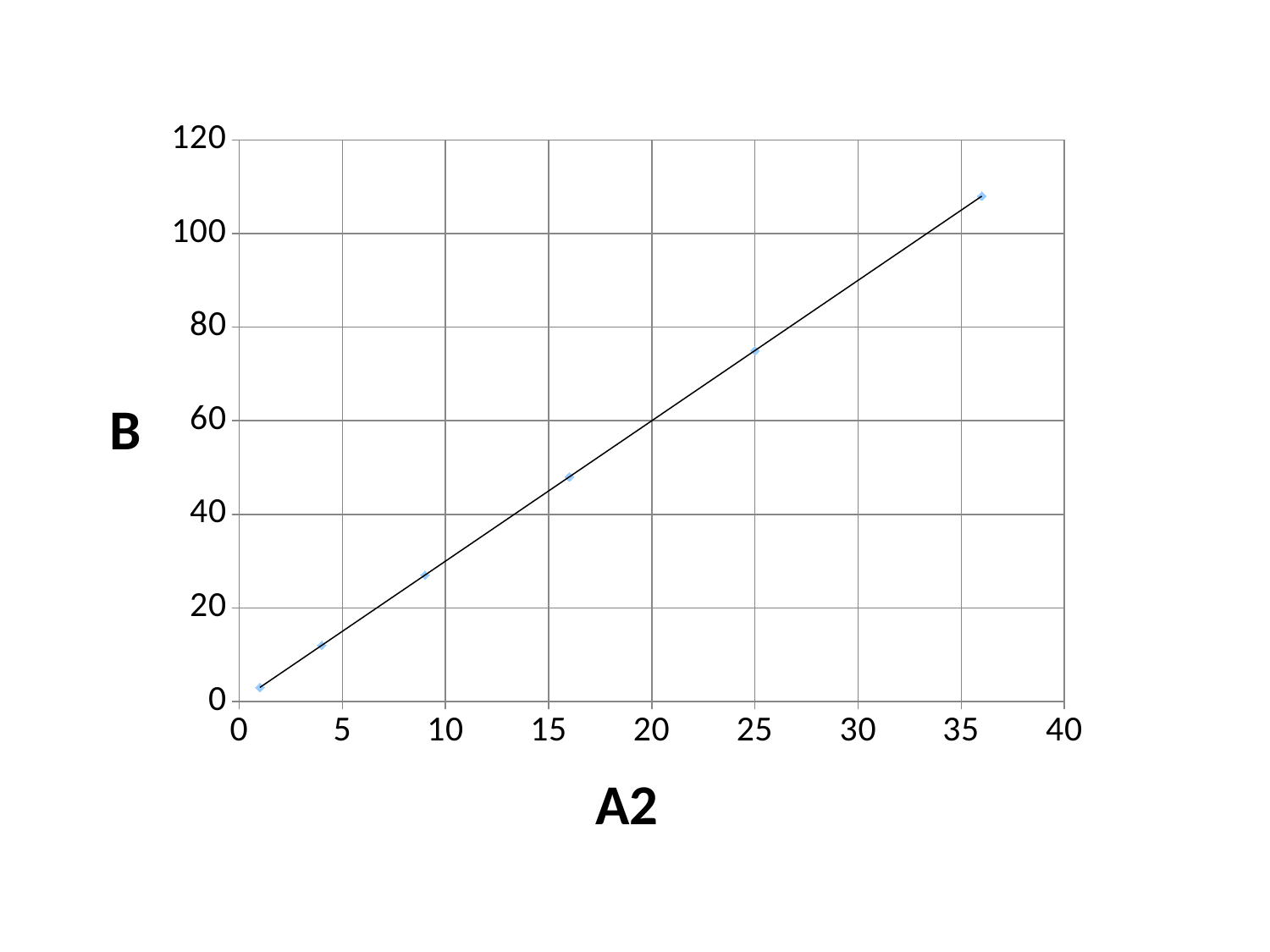
Is the value of B for the point at A2 = 9 greater or less than 20? greater What is the label of the horizontal axis? A2 Is the value of B for the point at A2 = 25 greater or less than 80? less Is the value of B for the point at A2 = 16 greater or less than 40? greater Which plotted point has the lowest value of B? the point at A2 = 1 Which plotted point has the highest value of B? the point at A2 = 36 What is the label of the vertical axis? B Do the values of B rise or fall as A2 increases? rise How many data points are plotted on the chart? 6 What kind of chart is shown on the slide? scatter chart